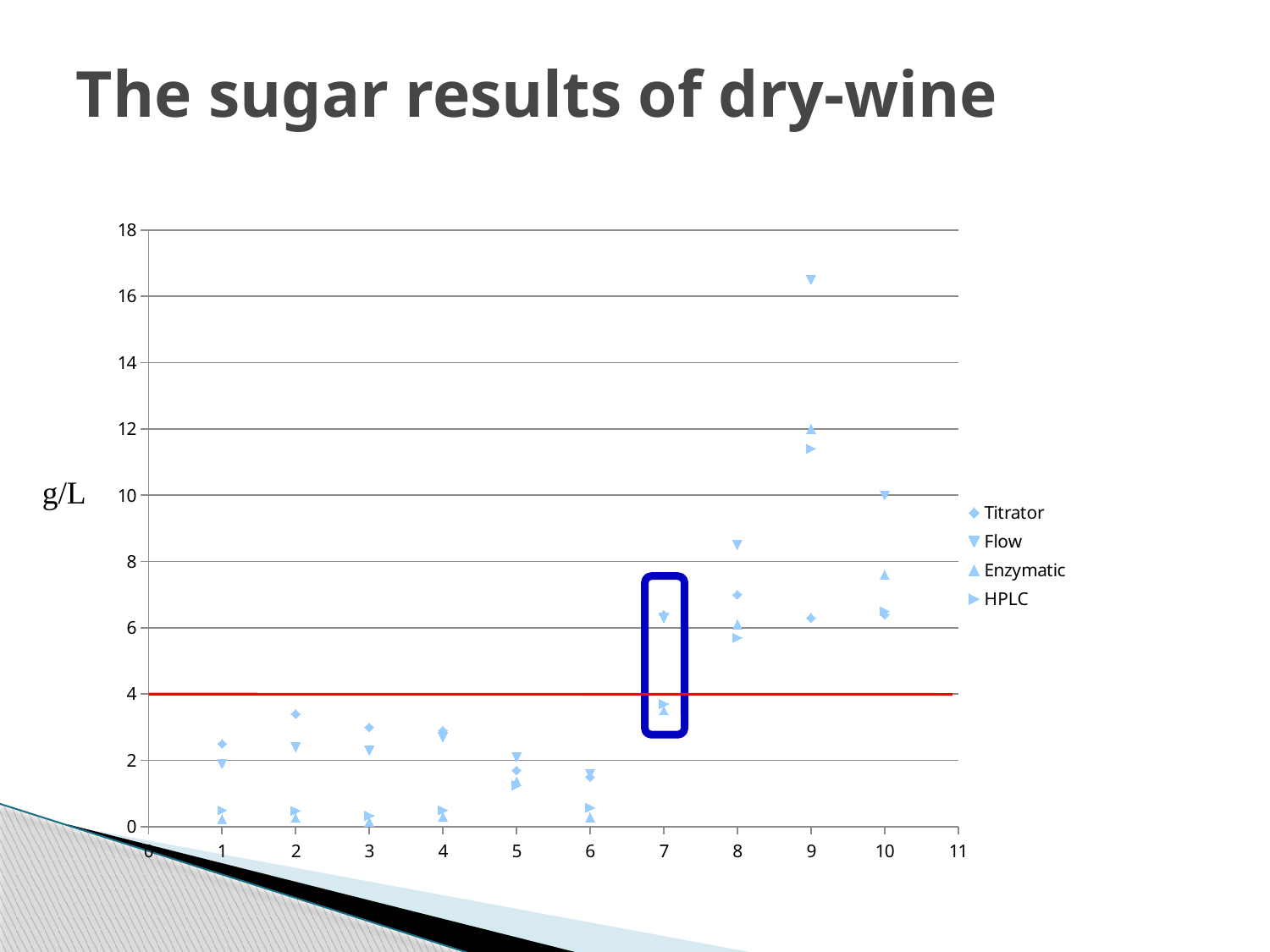
What are the series names listed in the legend? Titrator, Flow, Enzymatic, HPLC How many series does the legend list? 4 Is the HPLC value at sample 9 greater or less than 12? less Is the Titrator value at sample 8 greater or less than 6? greater At which sample number does the Flow series reach its highest value? 9 Which is larger at sample 10, the Flow value or the Titrator value? Flow Is the Flow value at sample 8 greater or less than 8? greater What kind of chart is shown on the slide? scatter chart What unit is shown on the y axis of the chart? g/L Which series has the highest value at sample 9? Flow